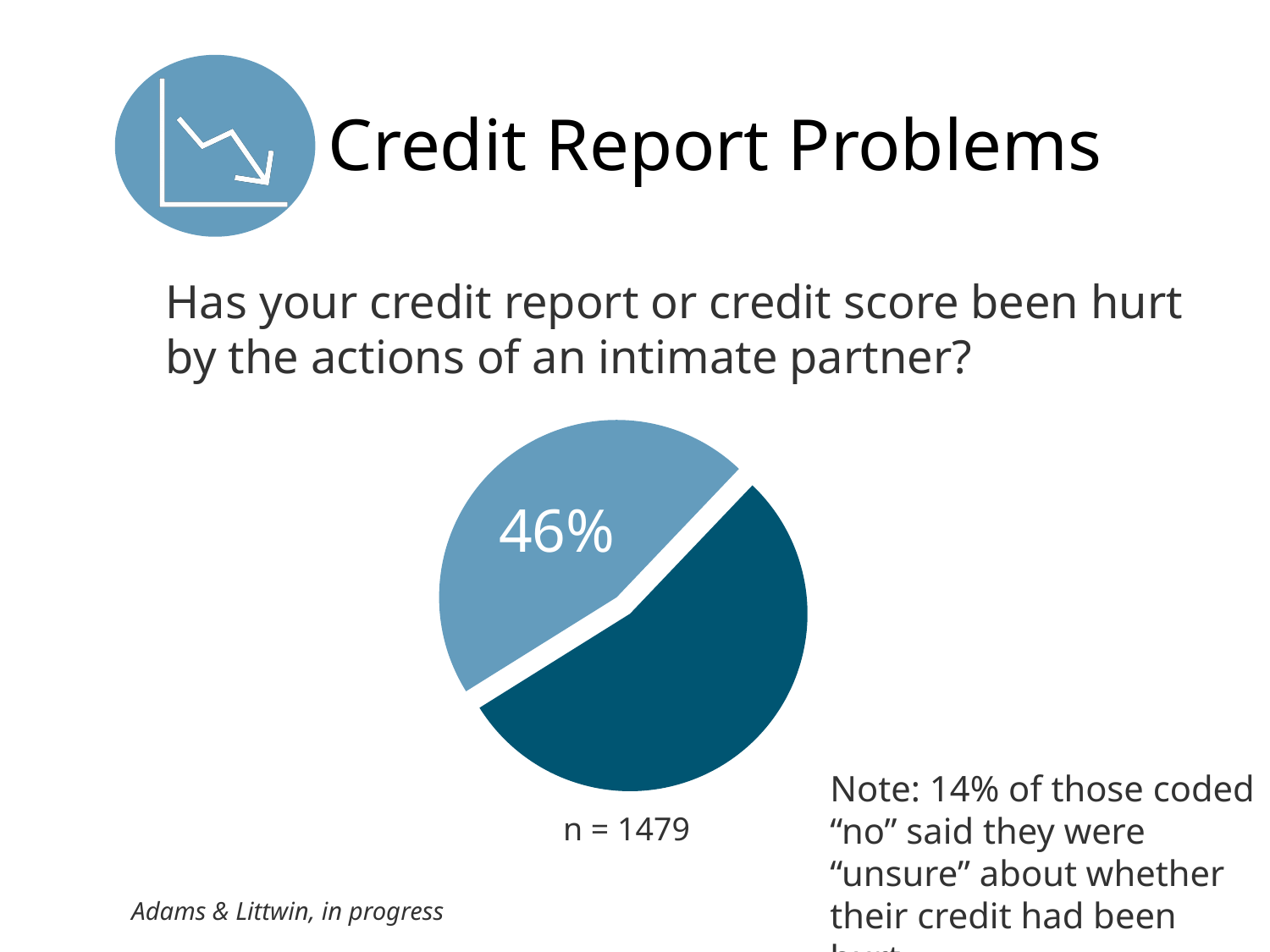
Is the dark blue slice's share of the pie greater or less than 50%? greater What percentage is printed on the light blue slice of the pie chart? 46% Is the light blue slice's share of the pie greater or less than 50%? less Which slice of the pie chart is larger, the light blue slice or the dark blue slice? dark blue How many slices does the pie chart have? 2 What sample size (n) is shown below the pie chart? n = 1479 What kind of chart is shown on the slide? pie chart What is the title of the slide containing the pie chart? Credit Report Problems Which slice of the pie chart is the smallest? the light blue slice (46%) Which slice of the pie chart is the largest? the dark blue slice